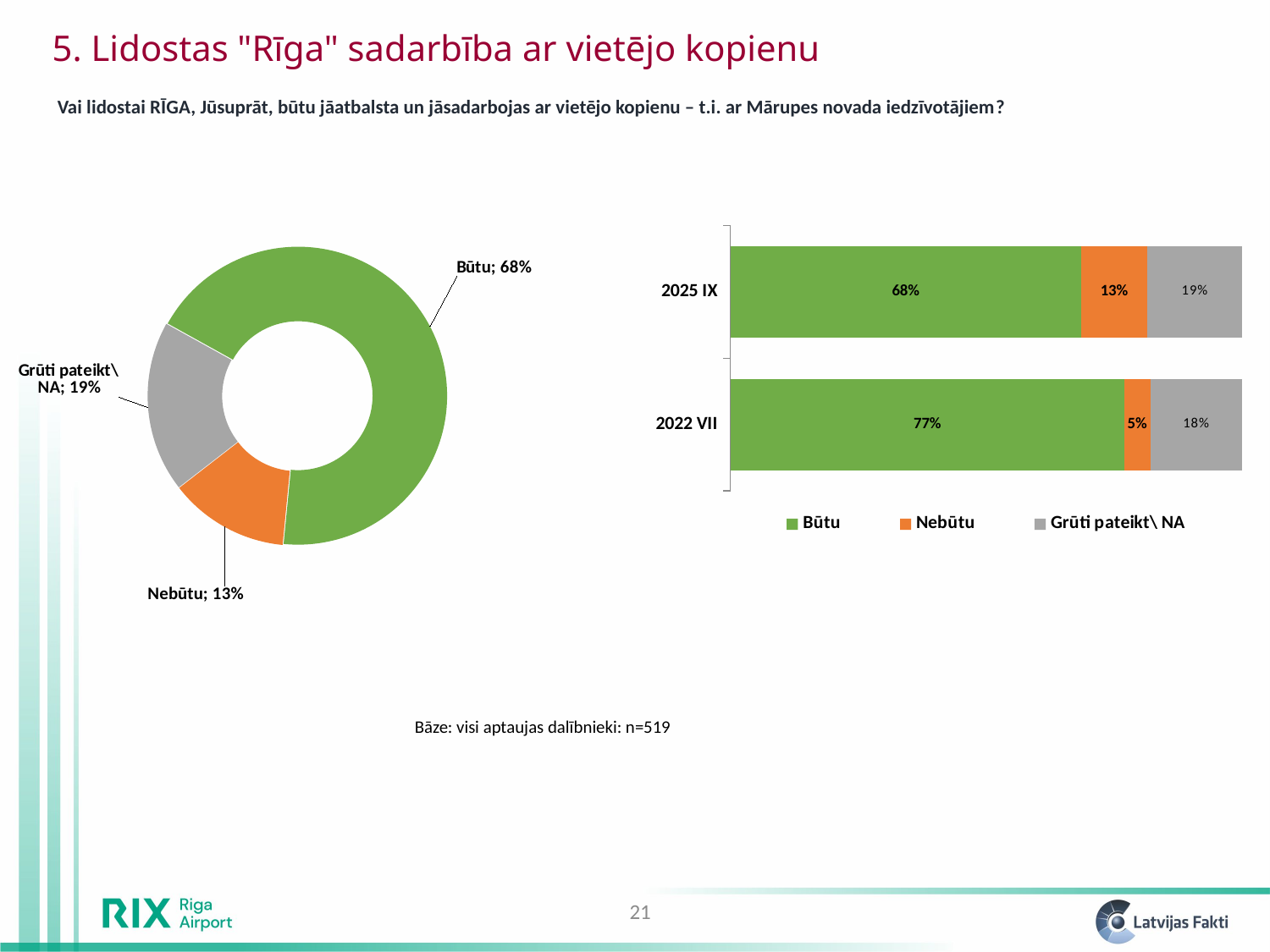
In the doughnut chart on the left, how many slices are there? 3 In the doughnut chart on the left, what share is labelled for "Būtu"? 68% In the stacked bar chart on the right, what is the difference between the "Būtu" values for 2022 VII and 2025 IX? 9% In the stacked bar chart on the right, how many series does the legend list? 3 In the doughnut chart on the left, which category has the smallest share? Nebūtu In the stacked bar chart on the right, what is the value for "Nebūtu" in 2025 IX? 13% In the stacked bar chart on the right, what is the value for "Būtu" in 2022 VII? 77% In the doughnut chart on the left, what share is labelled for "Nebūtu"? 13% What kind of chart is shown on the right side of the slide? Stacked bar chart In the stacked bar chart on the right, is the "Nebūtu" value larger in 2025 IX or in 2022 VII? 2025 IX In the doughnut chart on the left, which category has the largest share? Būtu In the stacked bar chart on the right, what is the value for "Grūti pateikt\ NA" in 2022 VII? 18%